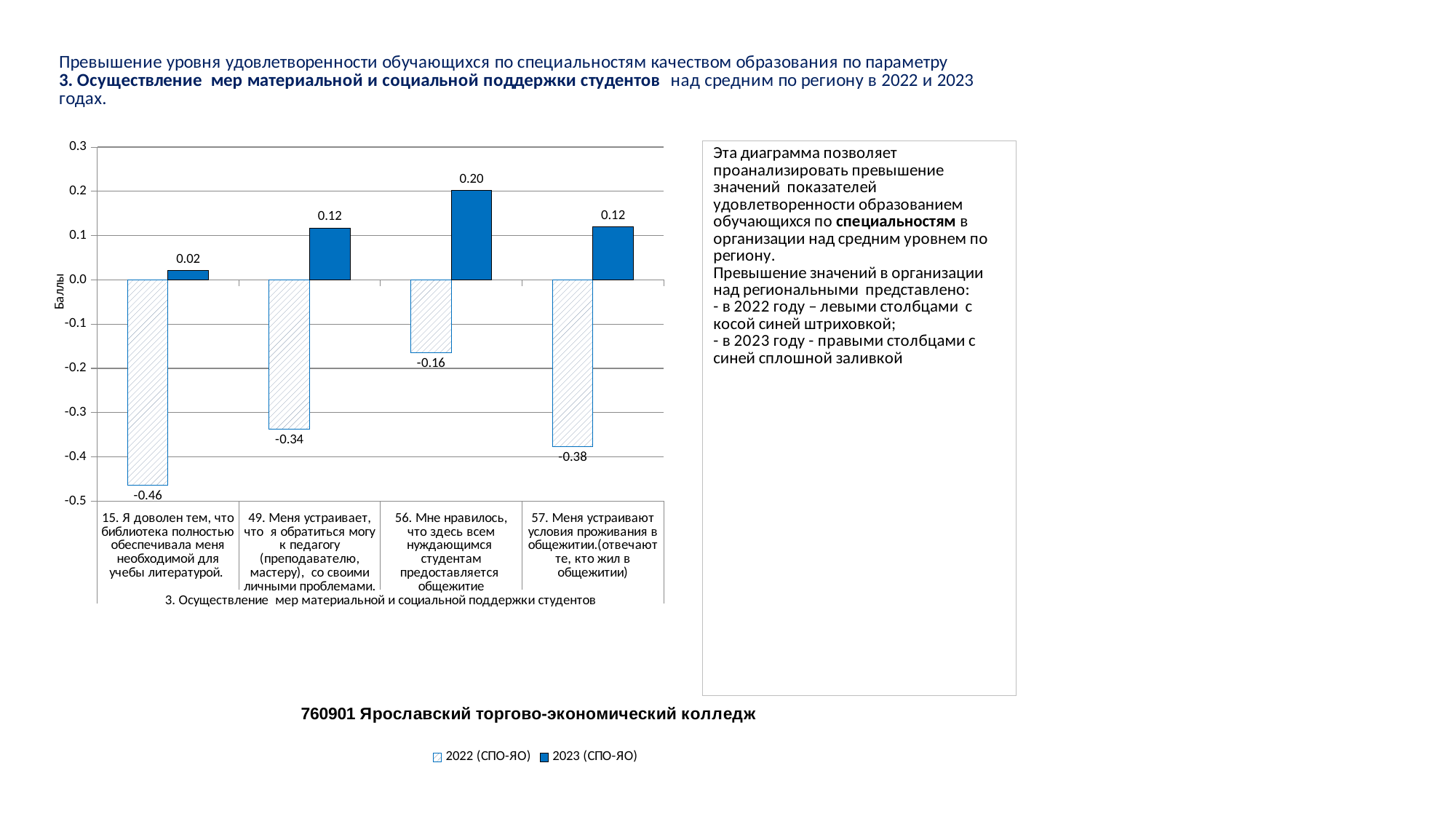
Which category has the highest value for the 2023 (СПО-ЯО) series? 56. Мне нравилось, что здесь всем нуждающимся студентам предоставляется общежитие What is the value for 2022 (СПО-ЯО) for category 49 (can approach a teacher with personal problems)? -0.34 What kind of chart is shown on the slide? Bar chart Is the 2022 value for category 57 greater or less than -0.3? less Which is larger: the 2023 value for category 49 or the 2023 value for category 15? Category 49 (0.12) What is the difference between the 2023 and 2022 values for category 56? 0.36 Which category has the lowest value for the 2022 (СПО-ЯО) series? 15. Я доволен тем, что библиотека полностью обеспечивала меня необходимой для учебы литературой. How many series does the legend list? 2 What is the value for 2022 (СПО-ЯО) for category 15 (library literature)? -0.46 What is the value for 2023 (СПО-ЯО) for category 56 (dormitory provided to all students in need)? 0.20 How many categories are shown on the x axis of the chart? 4 What is the value for 2023 (СПО-ЯО) for category 57 (dormitory living conditions)? 0.12